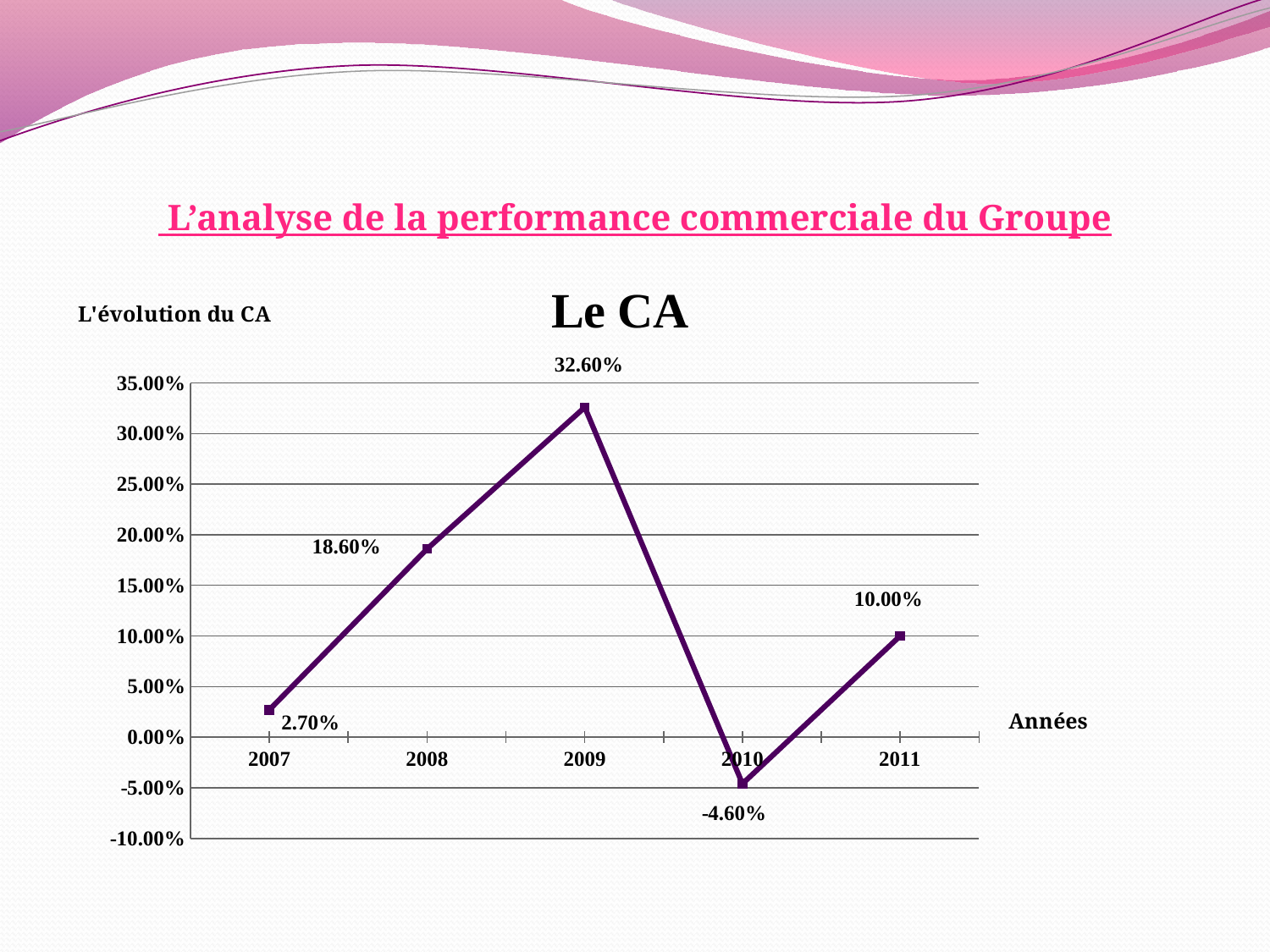
What is the value for 2011? 10.00% What kind of chart is shown? line chart What is the value for 2010? -4.60% What is the value for 2009? 32.60% What is the value for 2007? 2.70% How many years are plotted on the chart? 5 What is the difference between the values for 2009 and 2008? 14.00% Which year has the highest value? 2009 Which is larger, the value for 2008 or the value for 2011? 2008 What is the title of the chart? Le CA Which year has the lowest value? 2010 Is the value for 2008 greater or less than 15.00%? greater